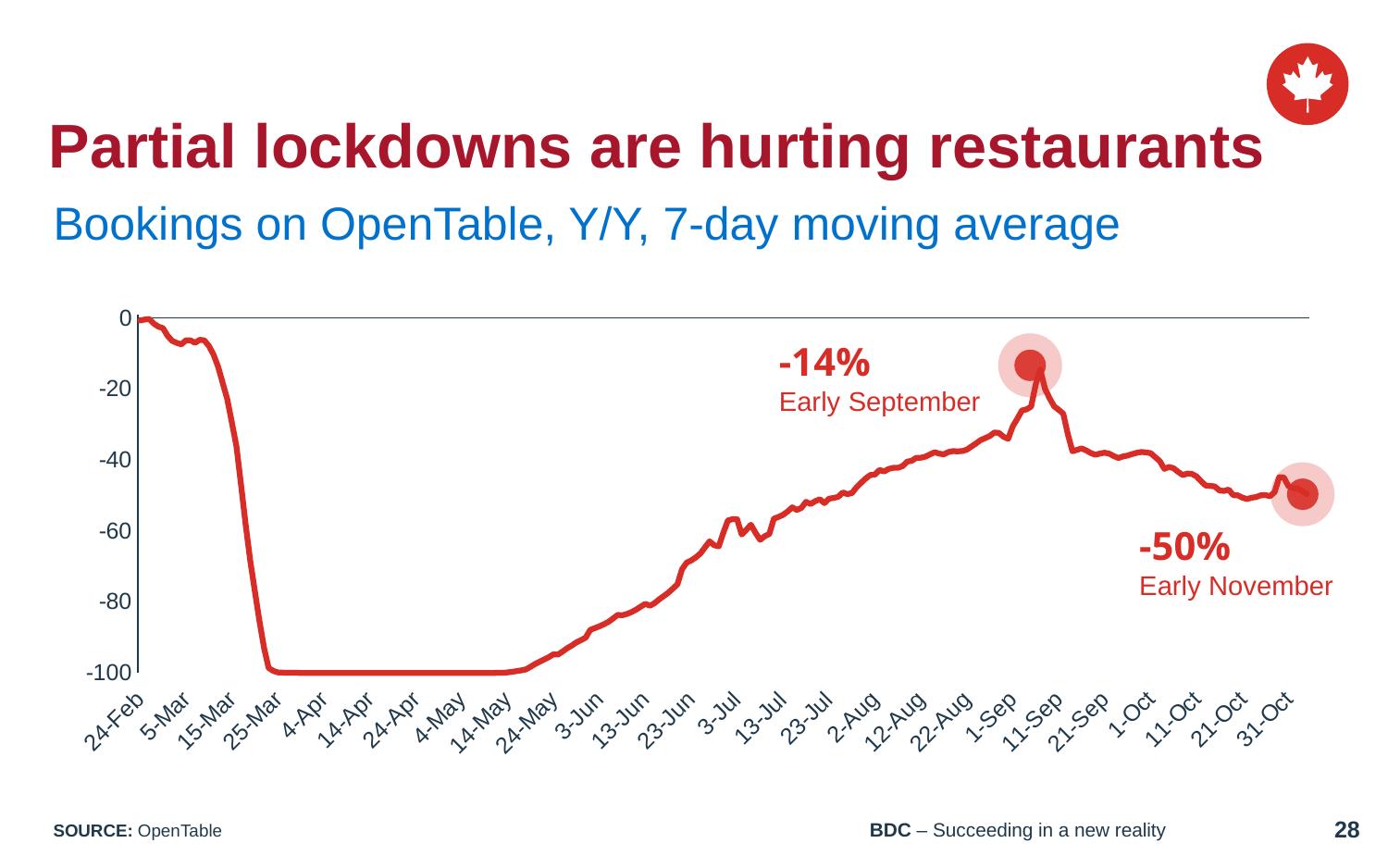
Does the line rise or fall between 24-Feb and 25-Mar? fall Is the value on 13-Jul greater or less than -80? greater What kind of chart is shown on the slide? line chart Is the value on 2-Aug greater or less than -60? greater What value is labelled on the chart for early November? -50% Is the value on 14-Apr greater or less than -80? less What value is labelled on the chart for early September? -14% What is the source cited for the chart data? OpenTable What is the lowest value the line reaches on the chart? -100 What is the difference between the early September value (-14%) and the early November value (-50%)? 36 percentage points Does the line rise or fall between 24-May and 1-Sep? rise Which labelled point is higher, early September or early November? Early September